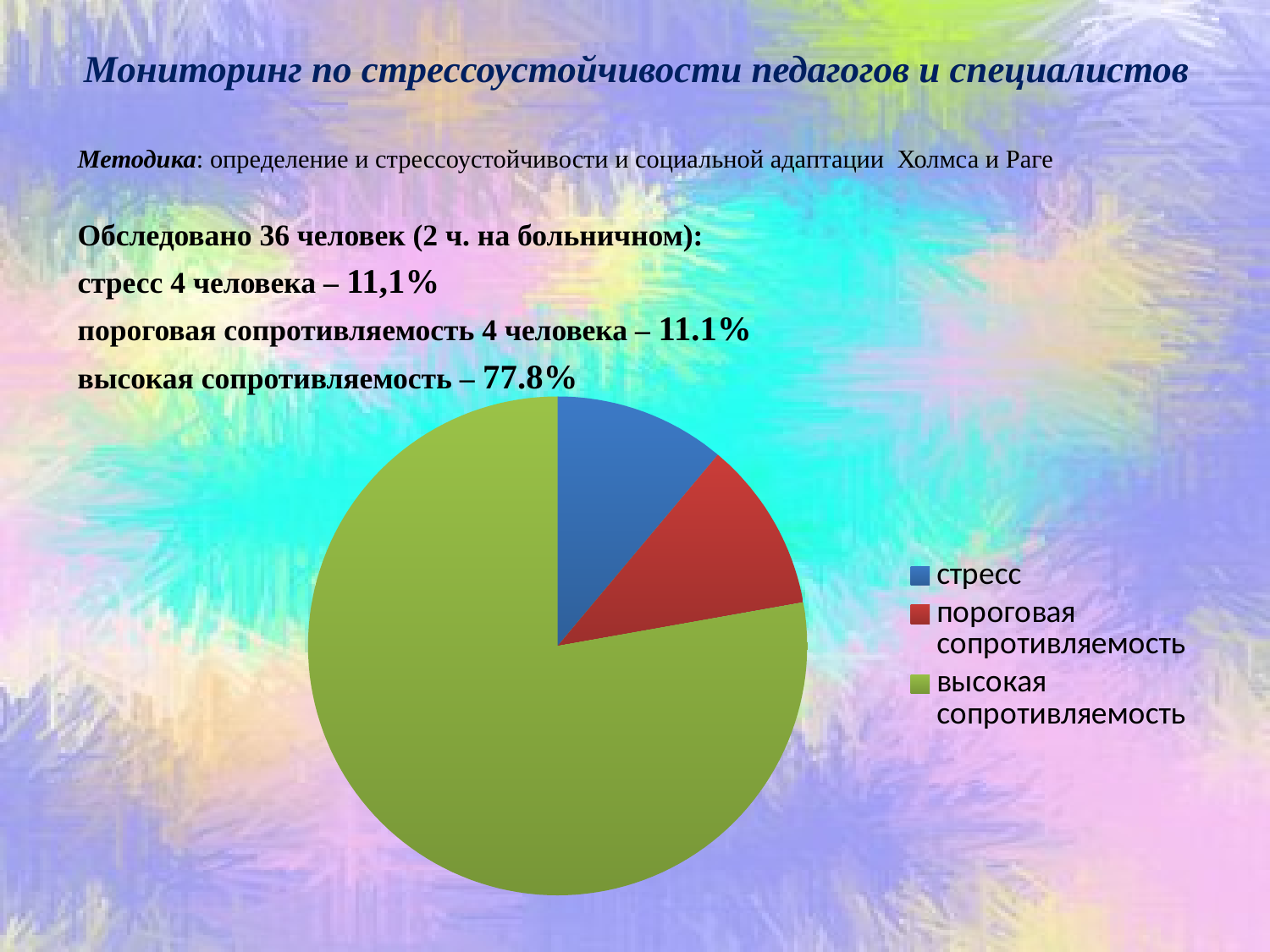
According to the slide, what share of those surveyed have пороговая сопротивляемость? 11.1% Which slice is larger: пороговая сопротивляемость or высокая сопротивляемость? высокая сопротивляемость According to the slide, what share of those surveyed have высокая сопротивляемость? 77.8% According to the slide, what share of those surveyed have стресс? 11,1% What kind of chart is shown on the slide? pie chart Which slice is larger: стресс or высокая сопротивляемость? высокая сопротивляемость Which category has the largest slice of the pie chart? высокая сопротивляемость How many people does the slide say were surveyed? 36 How many slices does the pie chart have? 3 How many people does the slide say fall into the стресс category? 4 What colour is the slice for высокая сопротивляемость in the pie chart? green What colour is the slice for стресс in the pie chart? blue